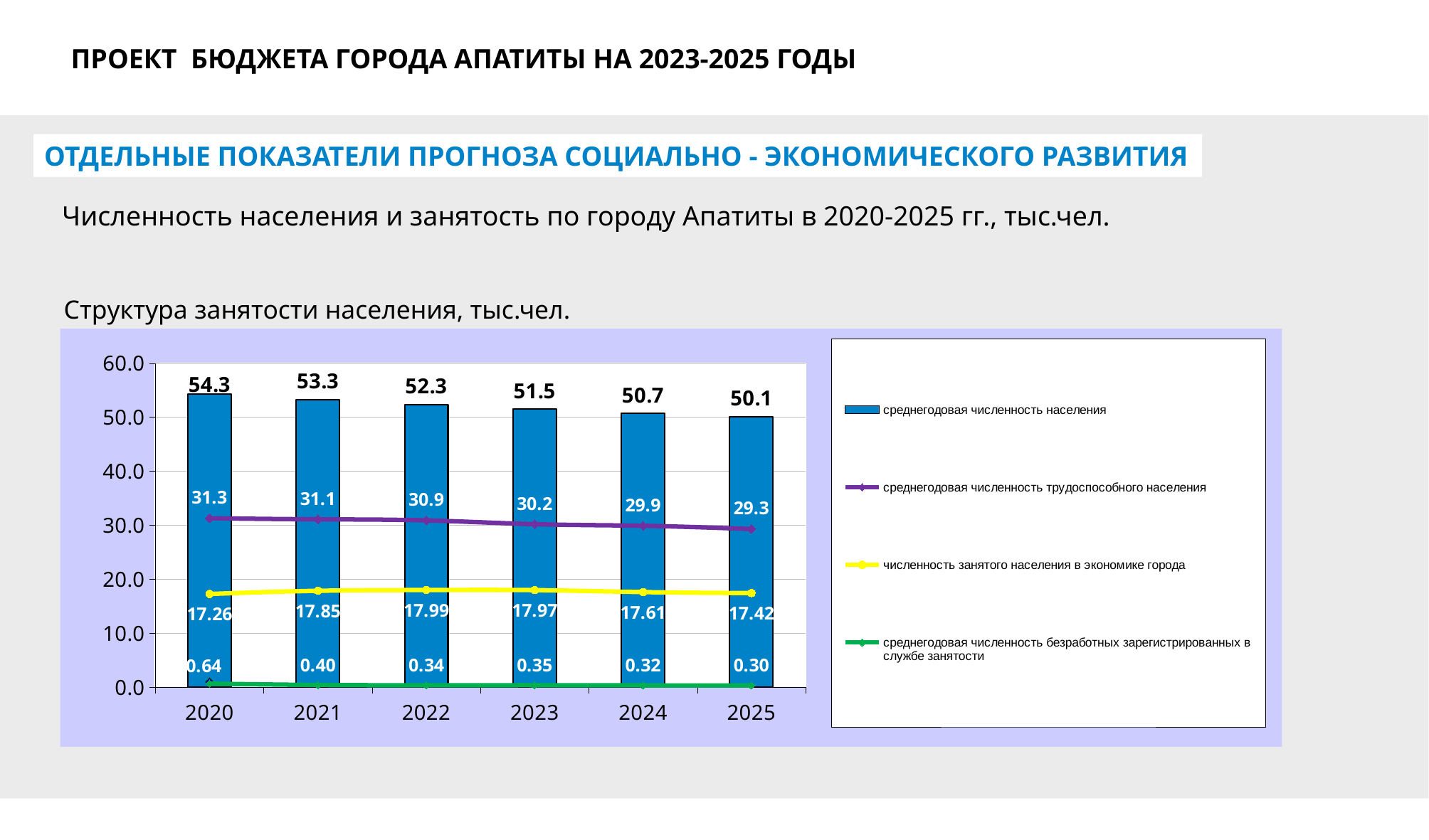
What is the value of численность занятого населения в экономике города for 2022? 17.99 In which year is численность занятого населения в экономике города the highest? 2022 Which is larger: the number of registered unemployed in 2020 or in 2021? 2020 How many years are shown on the x axis of the chart? 6 What is the value of среднегодовая численность трудоспособного населения for 2023? 30.2 What is the average annual population (среднегодовая численность населения) shown for 2020? 54.3 By how much does the average annual population decrease from 2020 to 2025? 4.2 In which year is the average annual population (bars) the lowest? 2025 What colour is the line for численность занятого населения в экономике города? yellow What is the value of среднегодовая численность безработных зарегистрированных в службе занятости for 2025? 0.30 How many series does the legend of the chart list? 4 Does the average annual population rise or fall from 2020 to 2025? fall